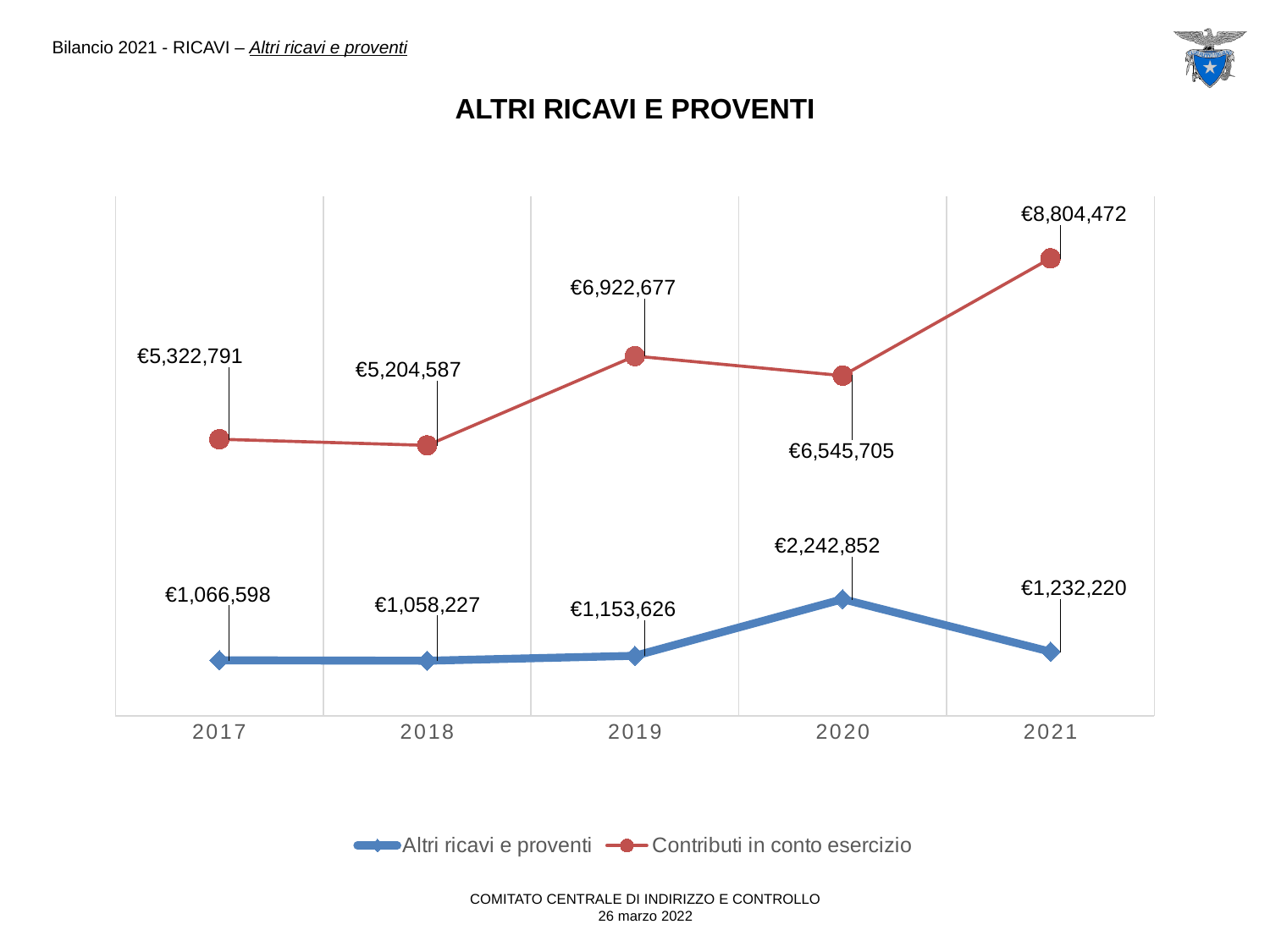
What is the difference between Contributi in conto esercizio and Altri ricavi e proventi in 2021? €7,572,252 What is the value of Altri ricavi e proventi in 2020? €2,242,852 What type of chart is shown on the slide? Line chart Which is larger: Contributi in conto esercizio in 2019 or in 2020? 2019 What is the value of Contributi in conto esercizio in 2018? €5,204,587 In which year is Altri ricavi e proventi lowest? 2018 How many years are shown on the x axis? 5 By how much did Contributi in conto esercizio increase from 2020 to 2021? €2,258,767 How many series does the legend list? 2 What is the value of Contributi in conto esercizio in 2021? €8,804,472 In which year is Contributi in conto esercizio highest? 2021 What is the title of the chart? ALTRI RICAVI E PROVENTI